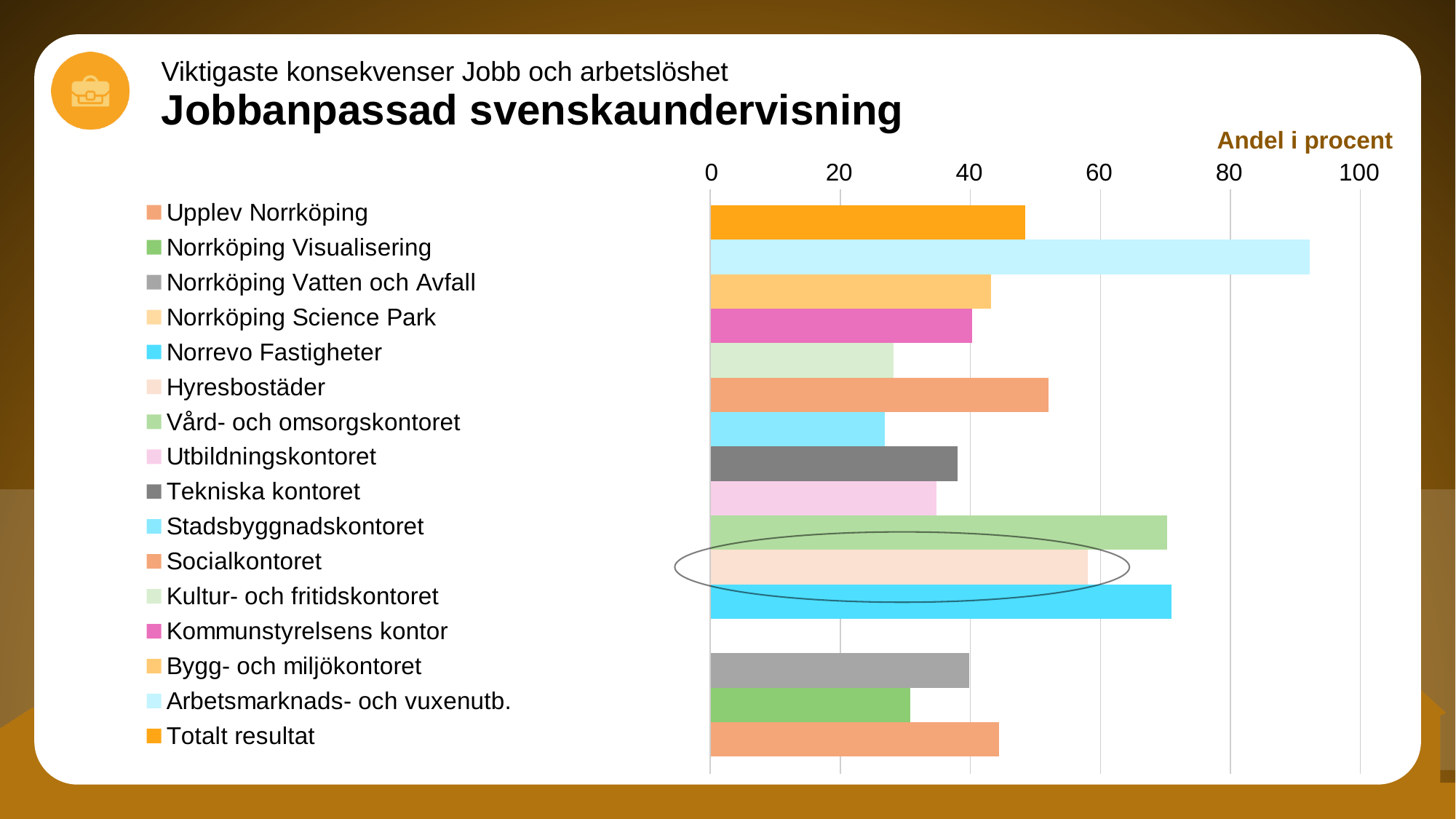
Which is larger, the value for Vård- och omsorgskontoret or the value for Kultur- och fritidskontoret? Vård- och omsorgskontoret Which is larger, the value for Arbetsmarknads- och vuxenutb. or the value for Totalt resultat? Arbetsmarknads- och vuxenutb. Is the value for Norrevo Fastigheter greater or less than 60? greater How many entries does the legend list? 16 Is the value for Kultur- och fritidskontoret greater or less than 40? less Is the value for Utbildningskontoret greater or less than 40? less What kind of chart is shown on the slide? bar chart What label is shown above the horizontal axis of the chart? Andel i procent Which category has the highest value in the chart? Arbetsmarknads- och vuxenutb.